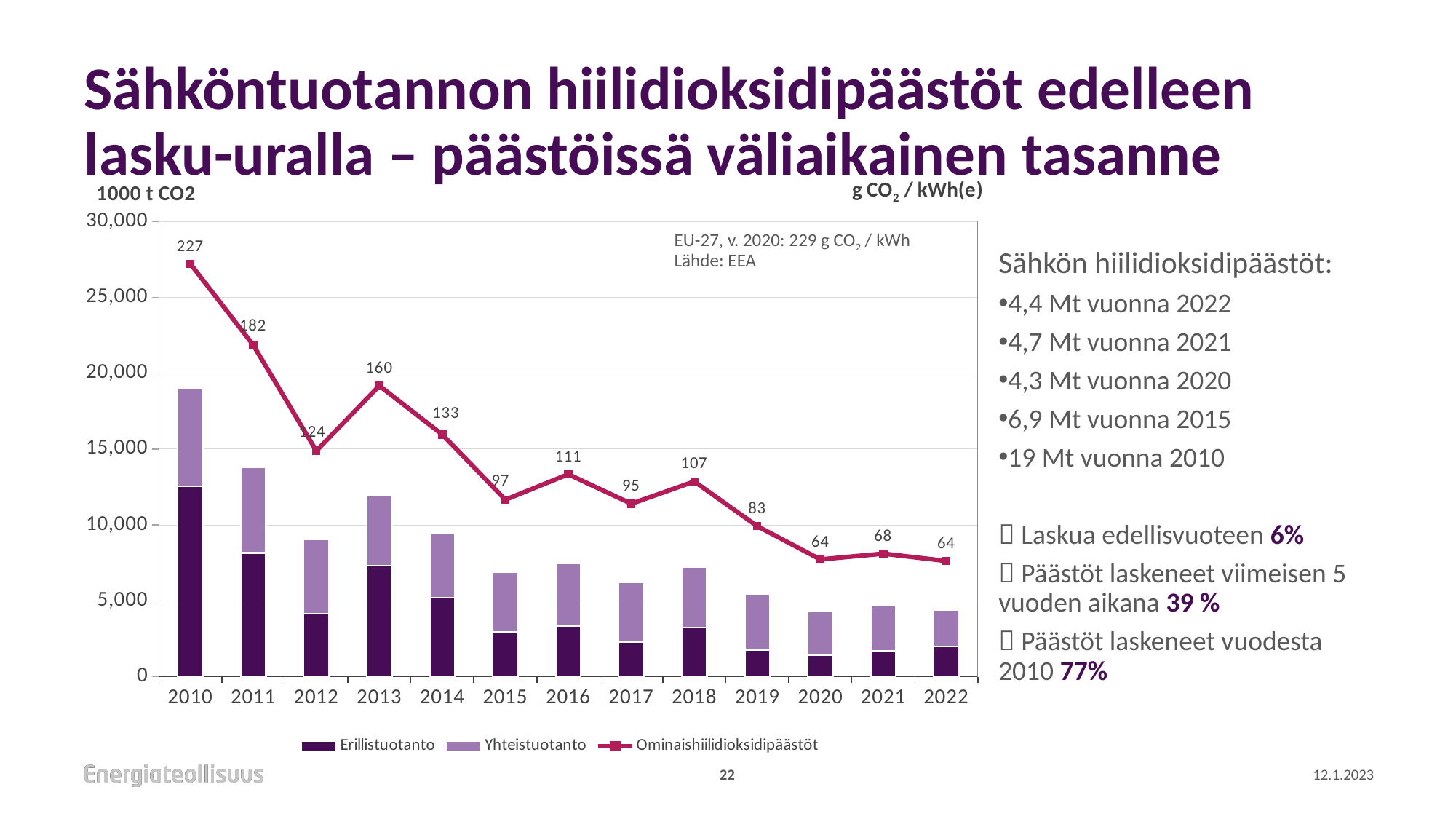
What is the value of the Ominaishiilidioksidipäästöt line for 2010? 227 Is the total stacked bar for 2022 greater or less than 5,000? less How many years are shown on the x axis of the chart? 13 Does the Ominaishiilidioksidipäästöt line generally rise or fall from 2010 to 2022? fall In which year is the Ominaishiilidioksidipäästöt line at its highest? 2010 Is the total stacked bar for 2010 greater or less than 15,000? greater What is the value of the Ominaishiilidioksidipäästöt line for 2019? 83 What is the difference between the Ominaishiilidioksidipäästöt values for 2013 and 2014? 27 Which year has the larger Ominaishiilidioksidipäästöt value, 2016 or 2018? 2016 What is the difference between the Ominaishiilidioksidipäästöt values for 2010 and 2011? 45 How many series does the chart legend list? 3 What is the value of the Ominaishiilidioksidipäästöt line for 2021? 68